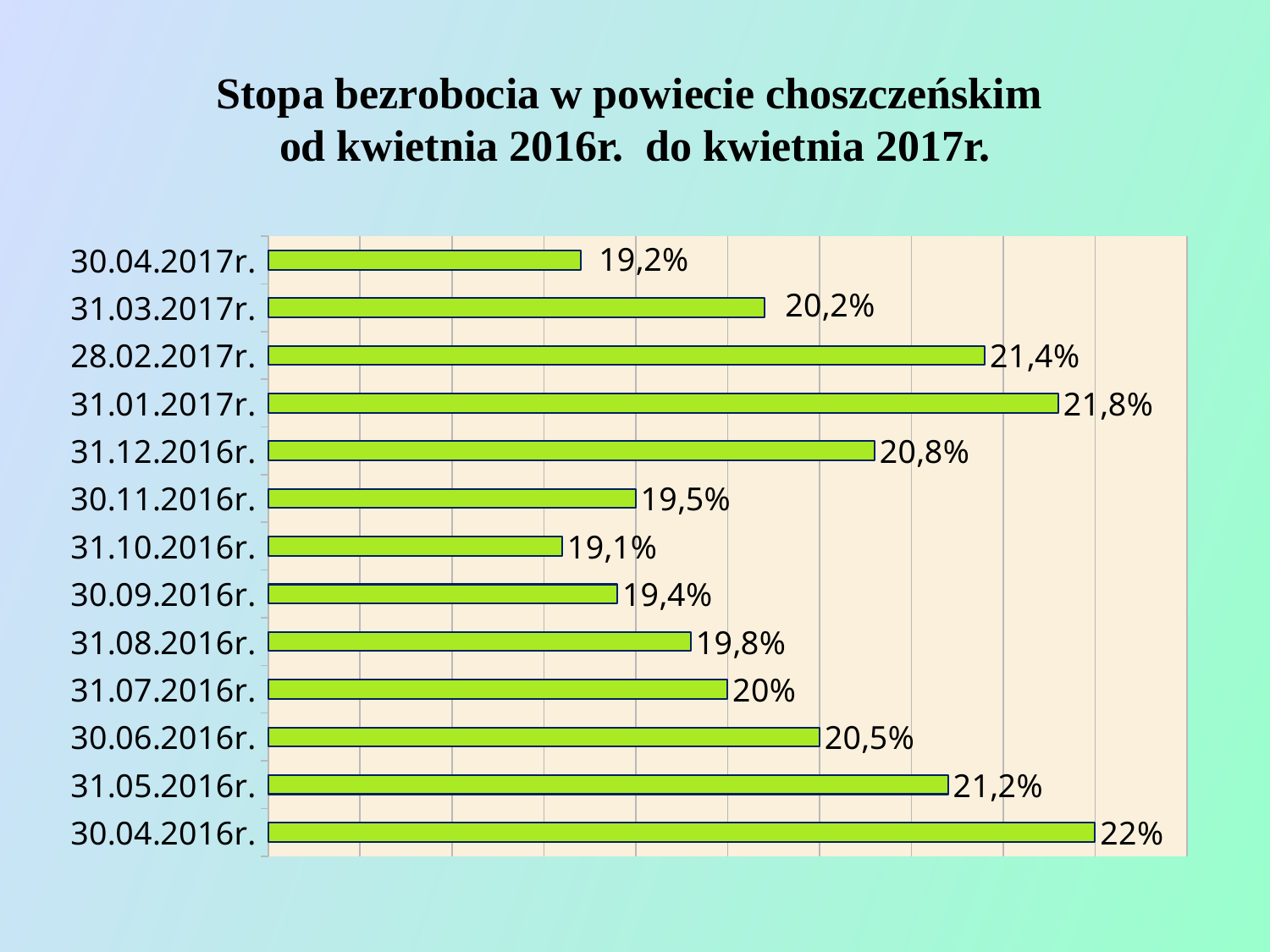
Which is larger, the value for 31.05.2016r. or the value for 30.06.2016r.? 31.05.2016r. Which date has the lowest unemployment rate? 31.10.2016r. What is the title of the chart on the slide? Stopa bezrobocia w powiecie choszczeńskim od kwietnia 2016r. do kwietnia 2017r. What kind of chart is shown on the slide? Bar chart What value is shown for 31.12.2016r.? 20,8% Does the unemployment rate rise or fall from 31.10.2016r. to 31.01.2017r.? Rise What is the unemployment rate shown for 30.04.2017r.? 19,2% What is the difference between the values for 30.04.2016r. and 30.04.2017r.? 2,8% Which date has the highest unemployment rate? 30.04.2016r. What is the difference between the values for 31.01.2017r. and 28.02.2017r.? 0,4% What is the value for 31.07.2016r.? 20% How many dates (bars) are shown in the chart? 13